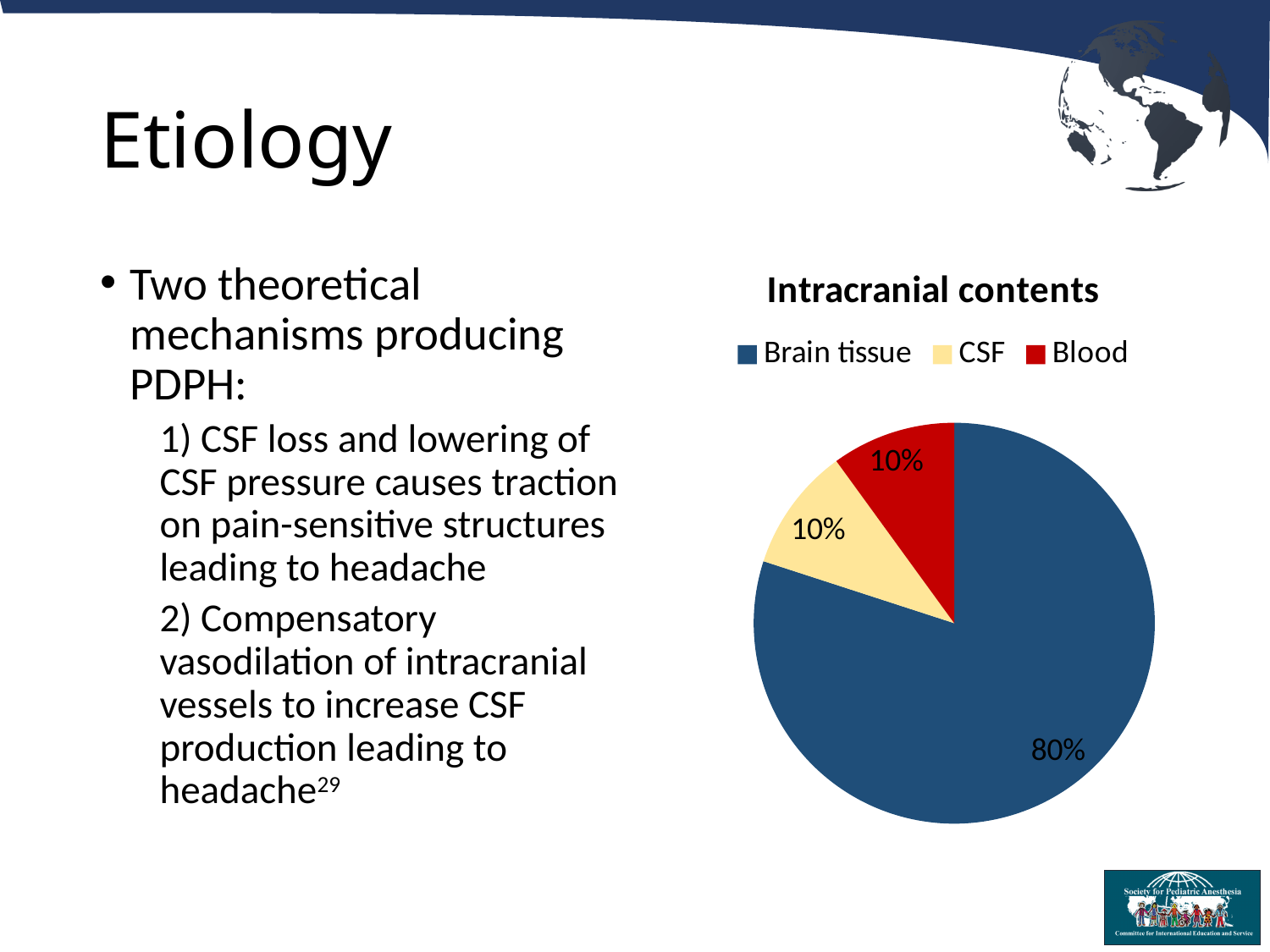
Which category is shown in red in the pie chart? Blood What is the combined share of CSF and Blood? 20% What kind of chart is shown on the slide? pie chart What share of the pie does CSF take? 10% Which is larger, the share for Brain tissue or the share for Blood? Brain tissue How many categories does the legend list? 3 Which category has the largest slice of the pie? Brain tissue What is the title of the chart? Intracranial contents What is the difference between the share for Brain tissue and the share for CSF? 70% What share of the pie does Blood take? 10% What share of the pie does Brain tissue take? 80%